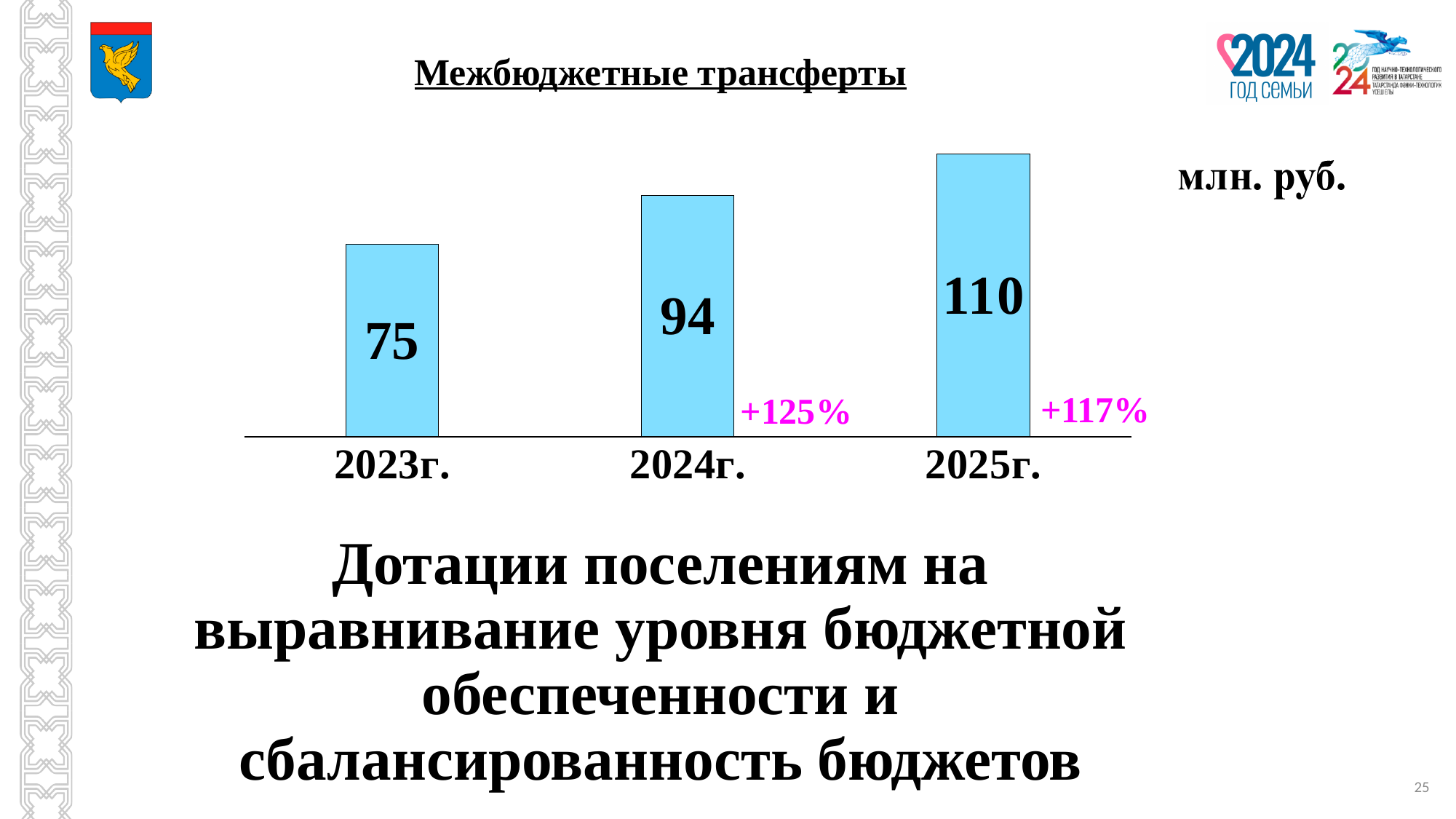
What is the difference between the values for 2024г. and 2023г.? 19 Which is larger, the value for 2024г. or the value for 2025г.? 2025г. What is the value for 2024г.? 94 Do the values rise or fall from 2023г. to 2025г.? rise What is the difference between the values for 2025г. and 2023г.? 35 Which year has the highest value? 2025г. What percentage change is shown next to the 2024г. bar? +125% What is the value for 2023г.? 75 How many bars are shown in the chart? 3 What kind of chart is shown on the slide? bar chart What is the value for 2025г.? 110 Which year has the lowest value? 2023г.